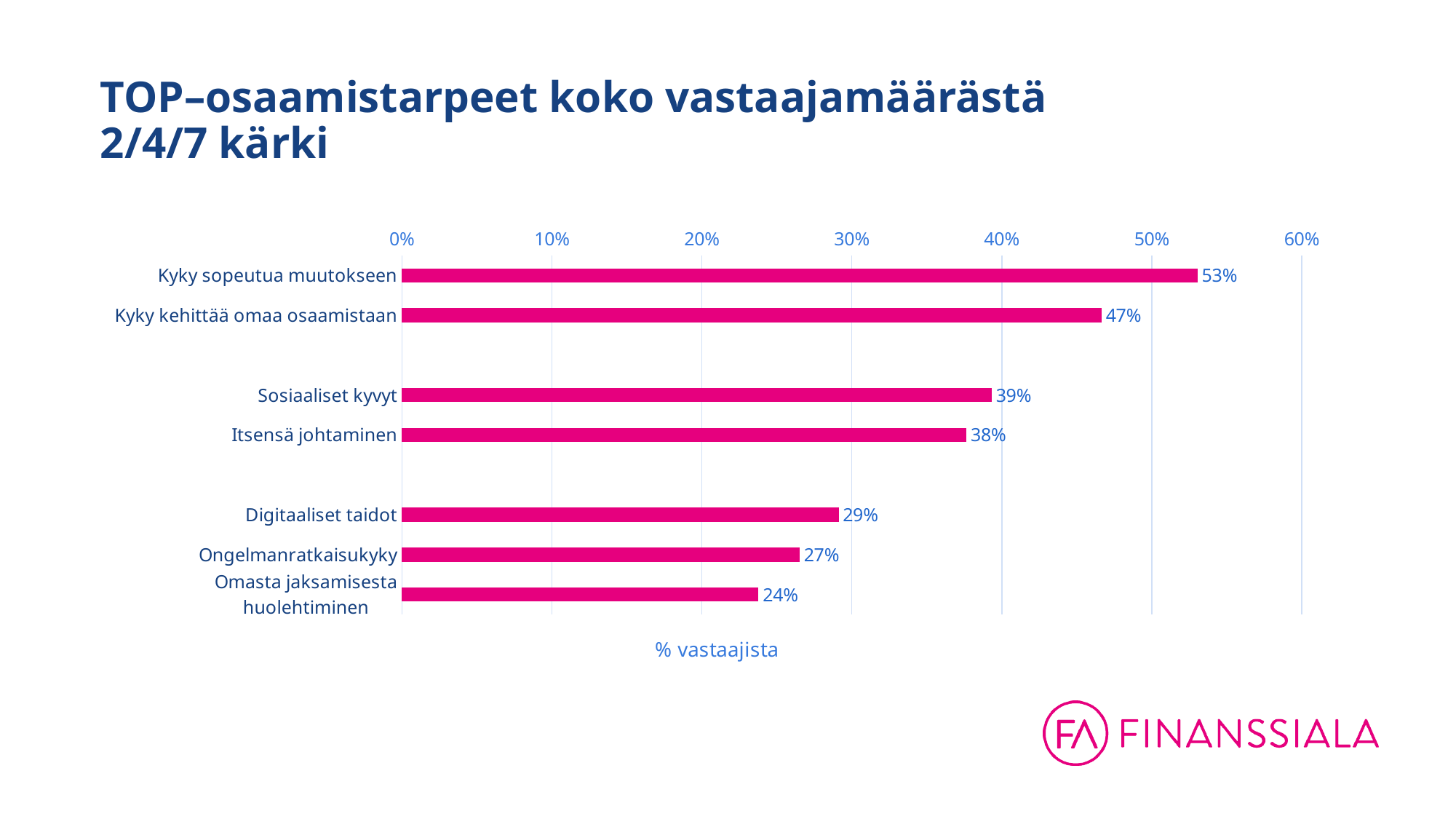
What is the value for Digitaaliset taidot? 29% What kind of chart is shown on the slide? Bar chart Is the value for Kyky kehittää omaa osaamistaan greater or less than 40%? greater What is the label of the horizontal axis? % vastaajista What is the difference between Kyky sopeutua muutokseen and Kyky kehittää omaa osaamistaan? 6% What is the value for Kyky sopeutua muutokseen? 53% How many categories are shown in the chart? 7 Which is larger, Itsensä johtaminen or Digitaaliset taidot? Itsensä johtaminen What is the difference between Sosiaaliset kyvyt and Ongelmanratkaisukyky? 12% Which category has the lowest value? Omasta jaksamisesta huolehtiminen Which category has the highest value? Kyky sopeutua muutokseen What is the value for Omasta jaksamisesta huolehtiminen? 24%